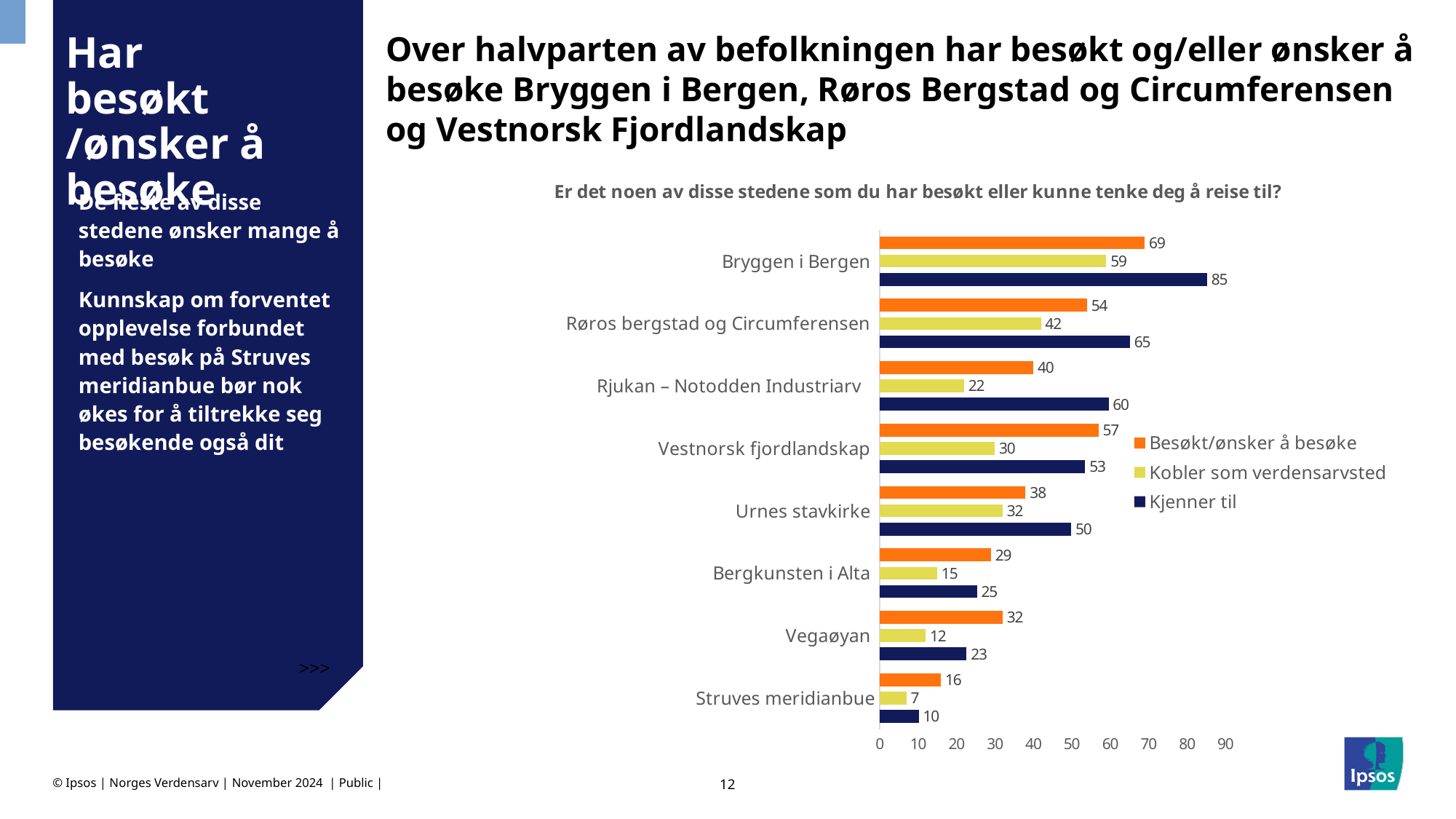
What is the 'Kobler som verdensarvsted' value for Vegaøyan? 12 What kind of chart is shown on the slide? Bar chart Which colour represents the 'Kjenner til' series? Dark blue What is the difference between the 'Kjenner til' and 'Besøkt/ønsker å besøke' values for Bryggen i Bergen? 16 How many series does the legend list? 3 Which site has the lowest 'Besøkt/ønsker å besøke' value? Struves meridianbue How many sites are listed on the chart? 8 What is the value for 'Besøkt/ønsker å besøke' for Bryggen i Bergen? 69 What is the 'Kjenner til' value for Rjukan – Notodden Industriarv? 60 Which is larger for Vestnorsk fjordlandskap: 'Besøkt/ønsker å besøke' or 'Kjenner til'? Besøkt/ønsker å besøke What is the question text shown above the chart? Er det noen av disse stedene som du har besøkt eller kunne tenke deg å reise til? Which site has the highest 'Kjenner til' value? Bryggen i Bergen